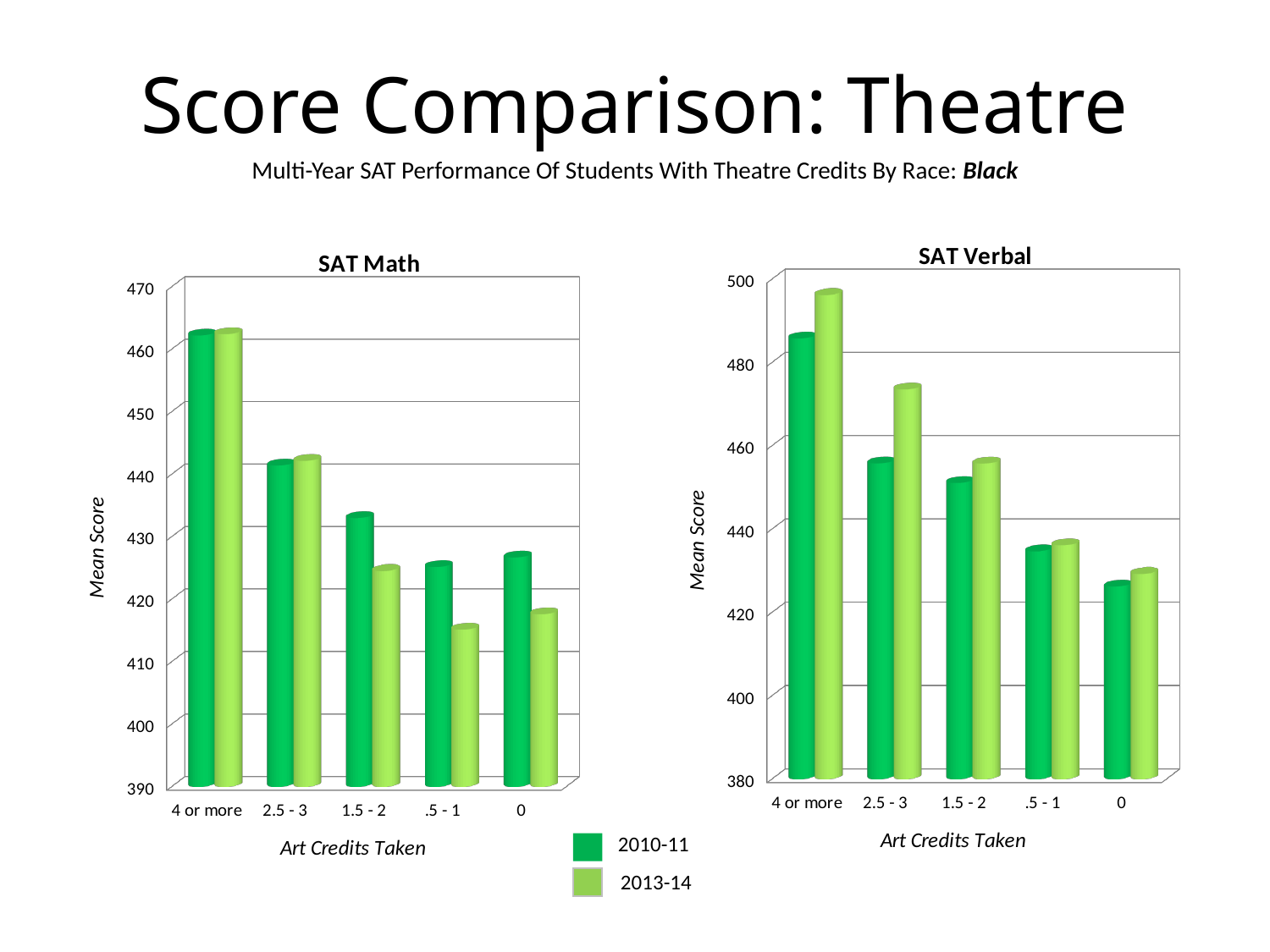
How many series does the legend list? 2 In the SAT Math chart, is the 2013-14 value for '.5 - 1' greater or less than 420? less In the SAT Verbal chart, which category has the lowest 2010-11 value? 0 In the SAT Math chart, for '1.5 - 2', which series has the larger value, 2010-11 or 2013-14? 2010-11 In the SAT Math chart, is the 2010-11 value for '4 or more' greater or less than 450? greater In the SAT Verbal chart, for '2.5 - 3', which series has the larger value, 2010-11 or 2013-14? 2013-14 In the SAT Verbal chart, is the 2013-14 value for '4 or more' greater or less than 480? greater How many categories are shown on the x axis of the SAT Verbal chart? 5 In the SAT Verbal chart, which category has the highest 2013-14 value? 4 or more In the SAT Verbal chart, do the 2010-11 values rise or fall moving from '4 or more' to '0' along the x axis? fall What kind of chart is the SAT Math chart? bar chart